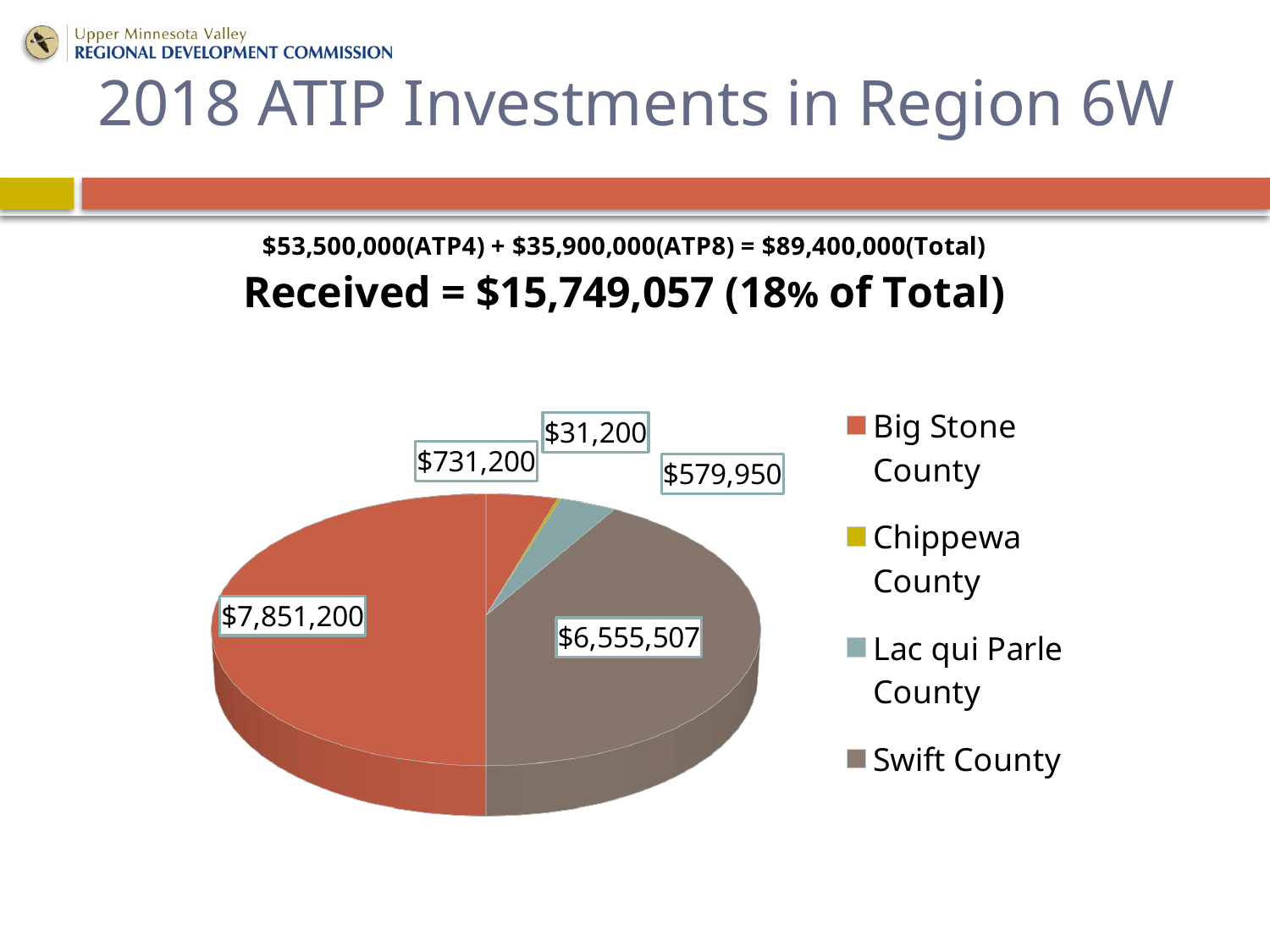
What is the value shown for Swift County? $6,555,507 How many counties are listed in the chart legend? 4 Which is larger, the value for Big Stone County or Swift County? Swift County What is the value shown for Big Stone County? $731,200 Which is larger, the value for Swift County or Lac qui Parle County? Swift County What is the difference between the values for Big Stone County and Swift County? $5,824,307 What colour represents Big Stone County in the pie chart? Red What is the title of the slide containing the chart? 2018 ATIP Investments in Region 6W What type of chart is shown on the slide? Pie chart What is the value shown for Lac qui Parle County? $579,950 Which county has the smallest slice of the pie? Chippewa County